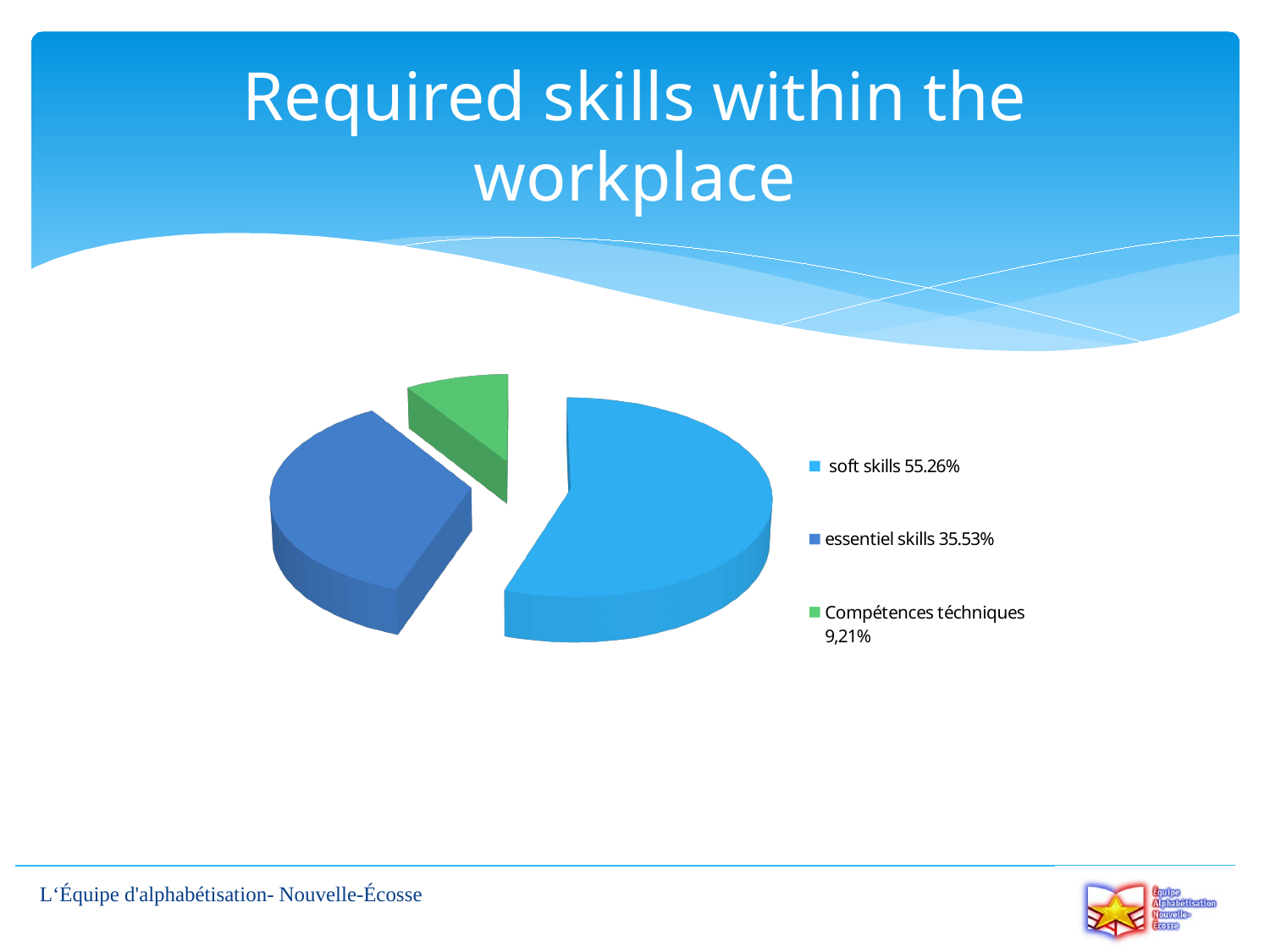
Which is larger, the slice for soft skills or the slice for essentiel skills? soft skills How many slices does the pie chart have? 3 Which category has the smallest slice of the pie? Compétences téchniques What is the title of the slide containing the pie chart? Required skills within the workplace What colour is the slice for Compétences téchniques? green What share of the pie is labelled for essentiel skills? 35.53% What is the difference in percentage points between the soft skills share and the essentiel skills share? 19.73 What share of the pie is labelled for Compétences téchniques? 9,21% What share of the pie is labelled for soft skills? 55.26% Which category has the largest slice of the pie? soft skills Which is larger, the slice for essentiel skills or the slice for Compétences téchniques? essentiel skills What kind of chart is shown on the slide? pie chart